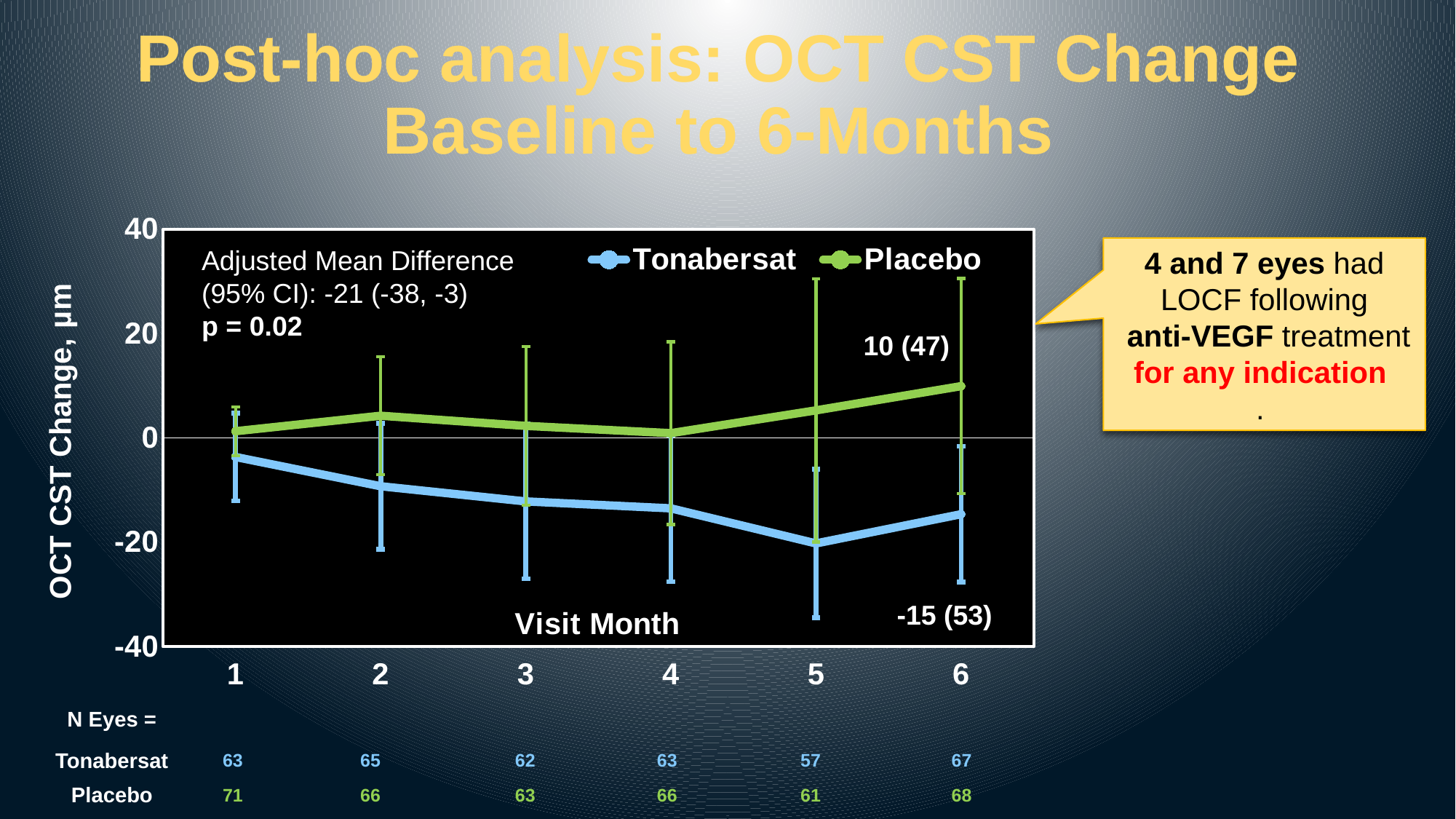
What is the difference between the Placebo value (10) and the Tonabersat value (-15) at visit month 6? 25 At visit month 6, which series has the higher OCT CST change, Tonabersat or Placebo? Placebo How many series does the chart legend list? 2 Is the Tonabersat value at visit month 1 greater or less than -20? greater At which visit month does the Tonabersat series reach its lowest value? 5 What data label is shown for Placebo at visit month 6? 10 (47) What is the title of the y axis? OCT CST Change, µm Does the Placebo series rise or fall from visit month 4 to visit month 6? rise What data label is shown for Tonabersat at visit month 6? -15 (53) How many visit months are plotted on the x axis? 6 Is the Tonabersat value at visit month 3 greater or less than 0? less What kind of chart is shown on the slide? line chart